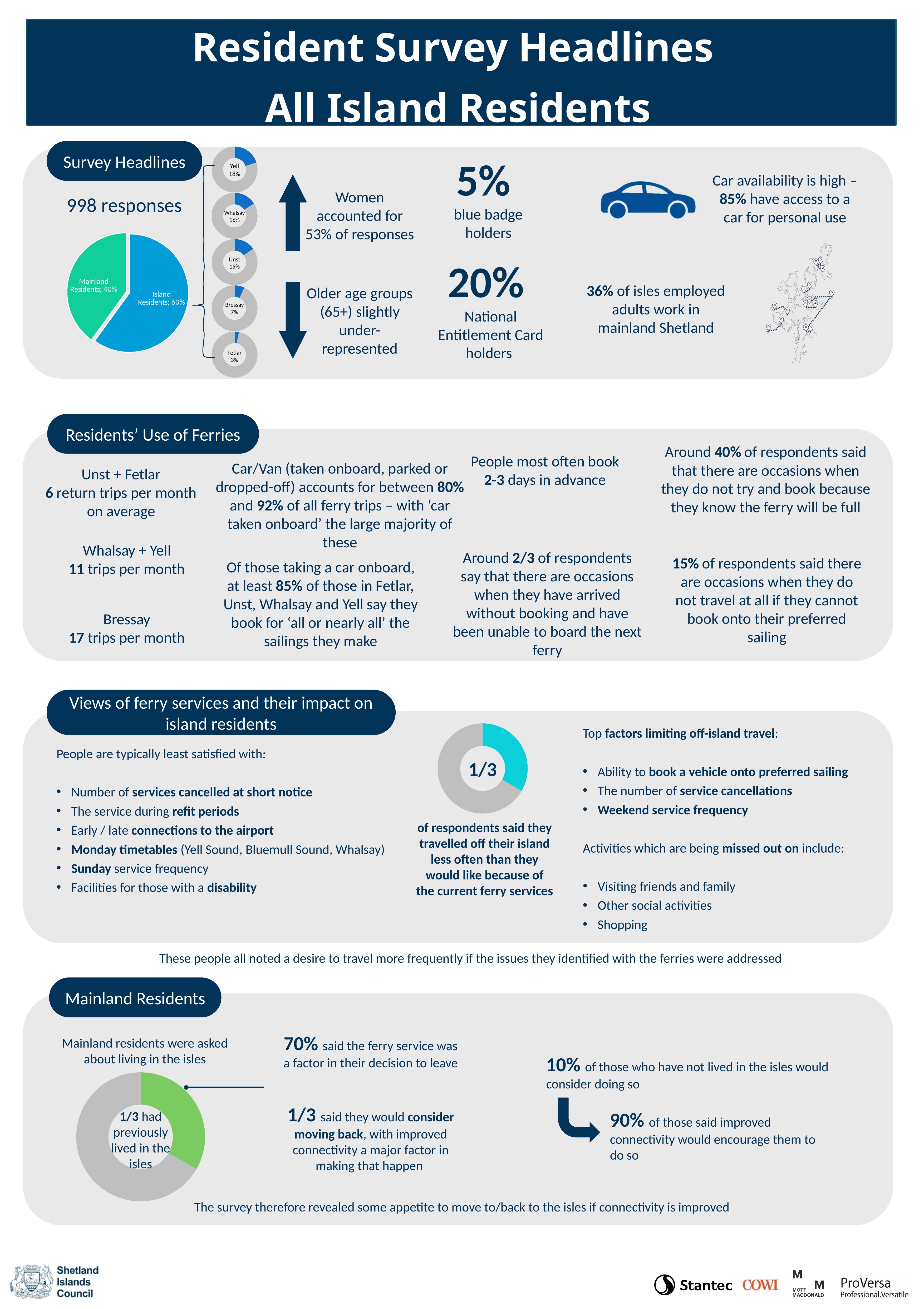
What kind of chart shows the split between Island Residents and Mainland Residents under Survey Headlines? Pie chart In the donut chart under Mainland Residents, what fraction of mainland residents had previously lived in the isles? 1/3 Among the small donut charts under Survey Headlines (Yell, Whalsay, Unst, Bressay, Fetlar), which island has the highest percentage? Yell In the pie chart under Survey Headlines, what is the difference in percentage points between the Island Residents and Mainland Residents slices? 20 How many slices does the pie chart under Survey Headlines have? 2 Among the small donut charts under Survey Headlines (Yell, Whalsay, Unst, Bressay, Fetlar), which island has the lowest percentage? Fetlar How many small island donut charts are shown next to the pie chart under Survey Headlines? 5 In the small donut charts under Survey Headlines, what percentage is shown for Bressay? 7% In the pie chart under Survey Headlines, what share of responses came from Island Residents? 60% In the pie chart under Survey Headlines, which slice is larger, Island Residents or Mainland Residents? Island Residents In the small donut charts under Survey Headlines, what percentage is shown for Yell? 18% In the pie chart under Survey Headlines, what share of responses came from Mainland Residents? 40%